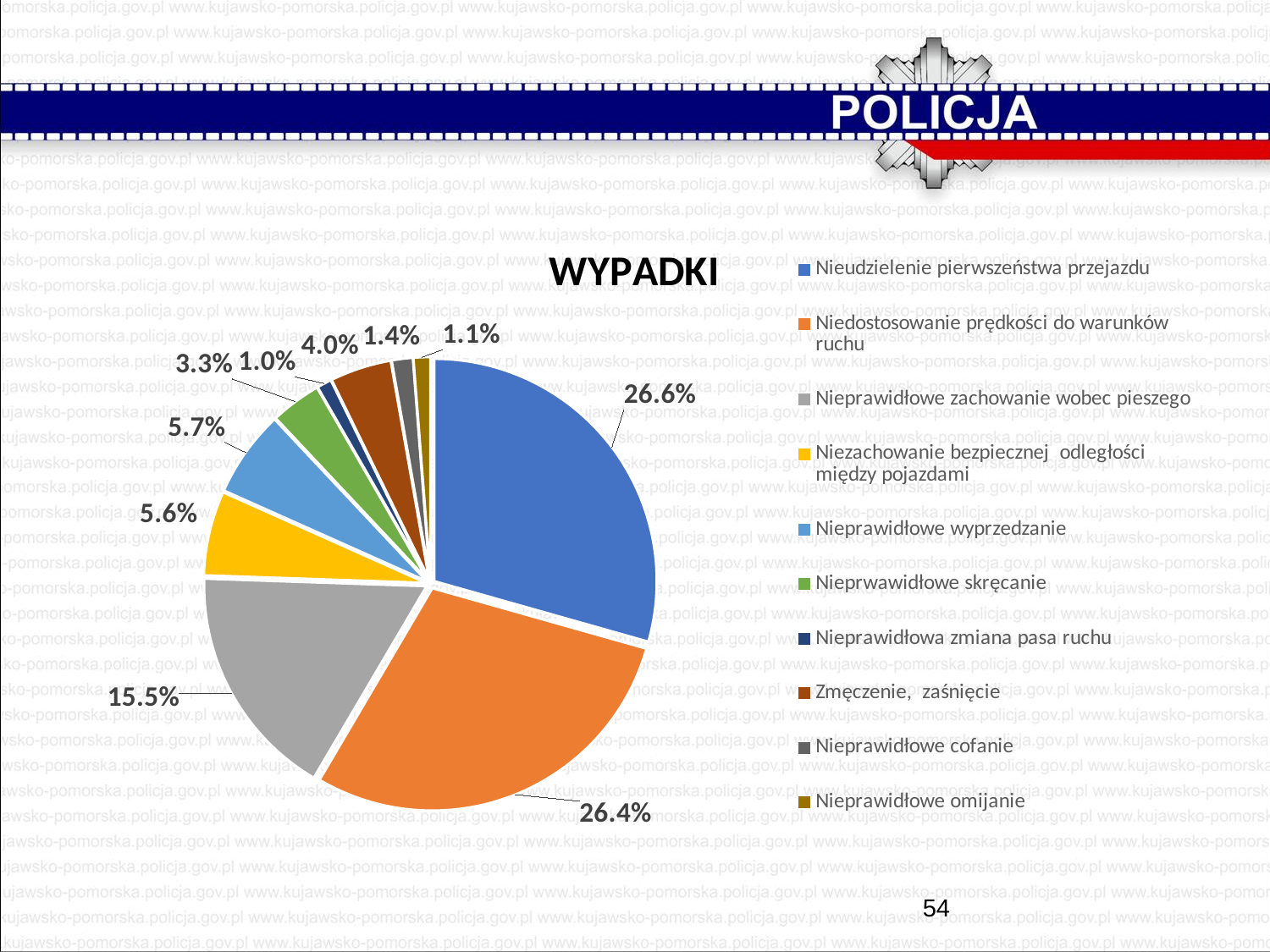
Which category has the largest share of the pie? Nieudzielenie pierwszeństwa przejazdu What type of chart is shown on the slide? pie chart What share of the pie is 'Niedostosowanie prędkości do warunków ruchu'? 26.4% Which category has the smallest share of the pie? Nieprawidłowa zmiana pasa ruchu What is the difference between the shares of 'Nieudzielenie pierwszeństwa przejazdu' and 'Nieprawidłowe zachowanie wobec pieszego'? 11.1% What share of the pie is 'Nieprawidłowe zachowanie wobec pieszego'? 15.5% What colour is the slice for 'Niezachowanie bezpiecznej odległości między pojazdami'? yellow What share of the pie is 'Nieudzielenie pierwszeństwa przejazdu'? 26.6% How many categories does the legend of the chart list? 10 What is the title of the chart? WYPADKI What share of the pie is 'Zmęczenie, zaśnięcie'? 4.0% Which has a larger share: 'Nieprawidłowe wyprzedzanie' or 'Nieprawidłowe skręcanie'? Nieprawidłowe wyprzedzanie